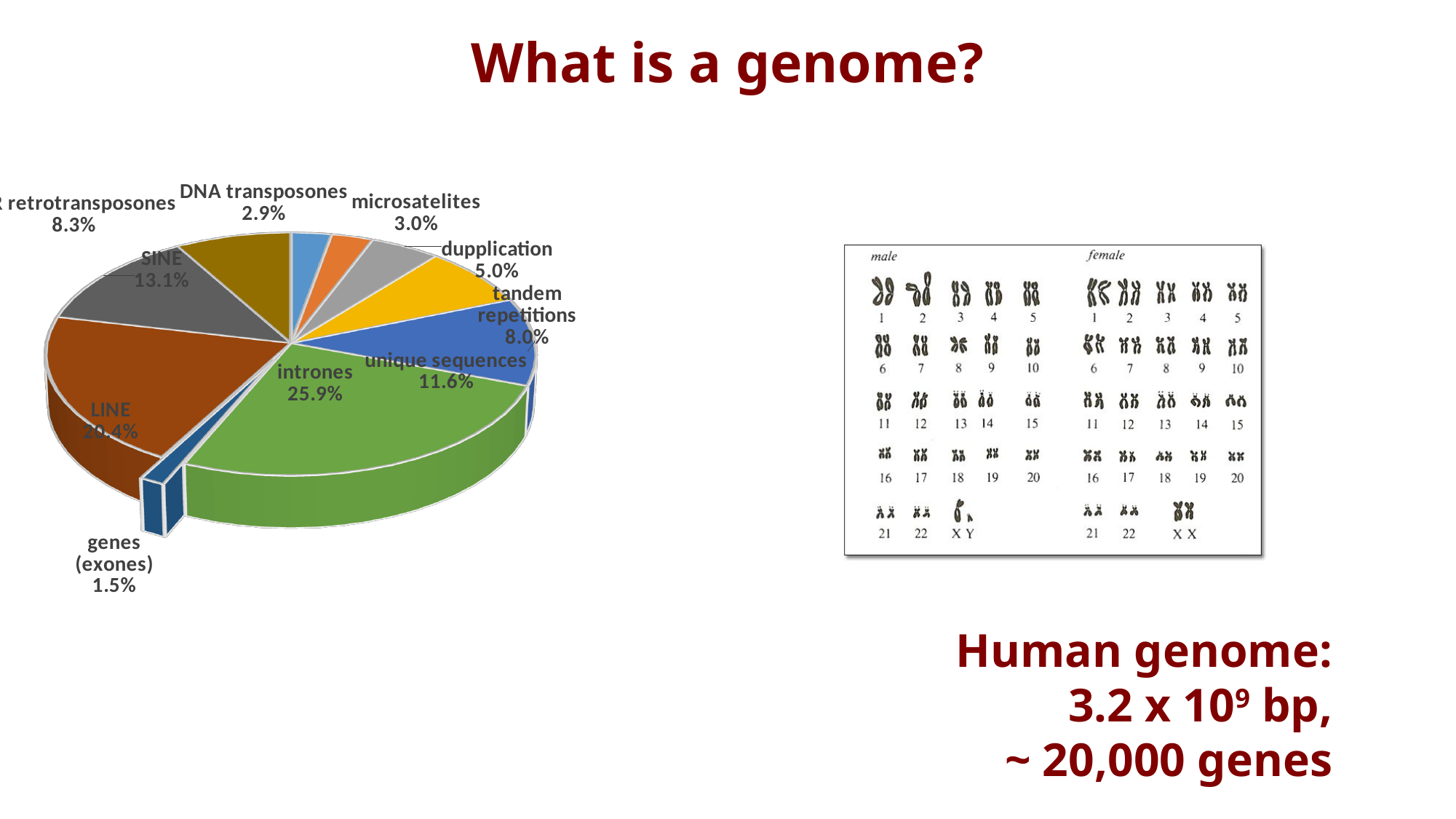
What percentage does the LINE slice show in the pie chart? 20.4% What is the difference between the unique sequences share and the tandem repetitions share? 3.6% What percentage is shown for genes (exones) in the pie chart? 1.5% How many slices does the pie chart have? 10 How many percentage points larger is the intrones slice than the LINE slice? 5.5% Which is larger in the pie chart, SINE or unique sequences? SINE What percentage of the genome is labelled as intrones in the pie chart? 25.9% Which slice of the pie chart has the smallest share? genes (exones) What percentage is shown for tandem repetitions in the pie chart? 8.0% Which slice is pulled out (exploded) from the rest of the pie chart? genes (exones) Which slice of the pie chart has the largest share? intrones What kind of chart is shown on the slide? pie chart